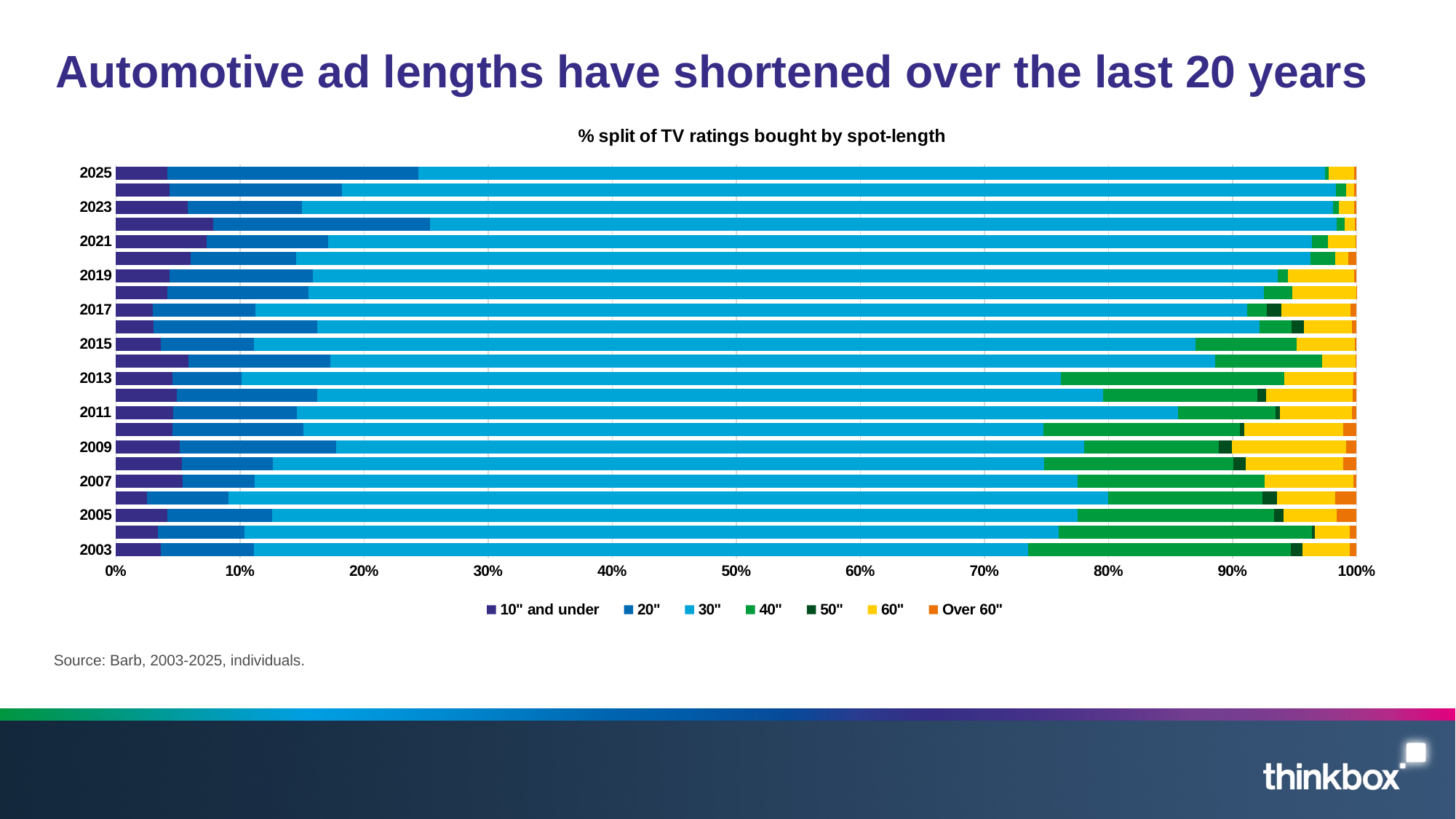
Is the share for 10" and under in 2025 greater or less than 10%? less How many series does the legend list? 7 How many bars (years) are plotted in the chart? 23 Is the share for 30" in 2025 greater or less than 60%? greater What kind of chart is shown on the slide? Stacked bar chart What is the title of the chart? % split of TV ratings bought by spot-length Does the share of 40" ads rise or fall from 2003 to 2025? fall Is the share for 40" in 2019 greater or less than 10%? less Which spot-length is shown in yellow in the legend? 60" Which year has the larger 40" share, 2013 or 2019? 2013 Which year has the larger 20" share, 2025 or 2023? 2025